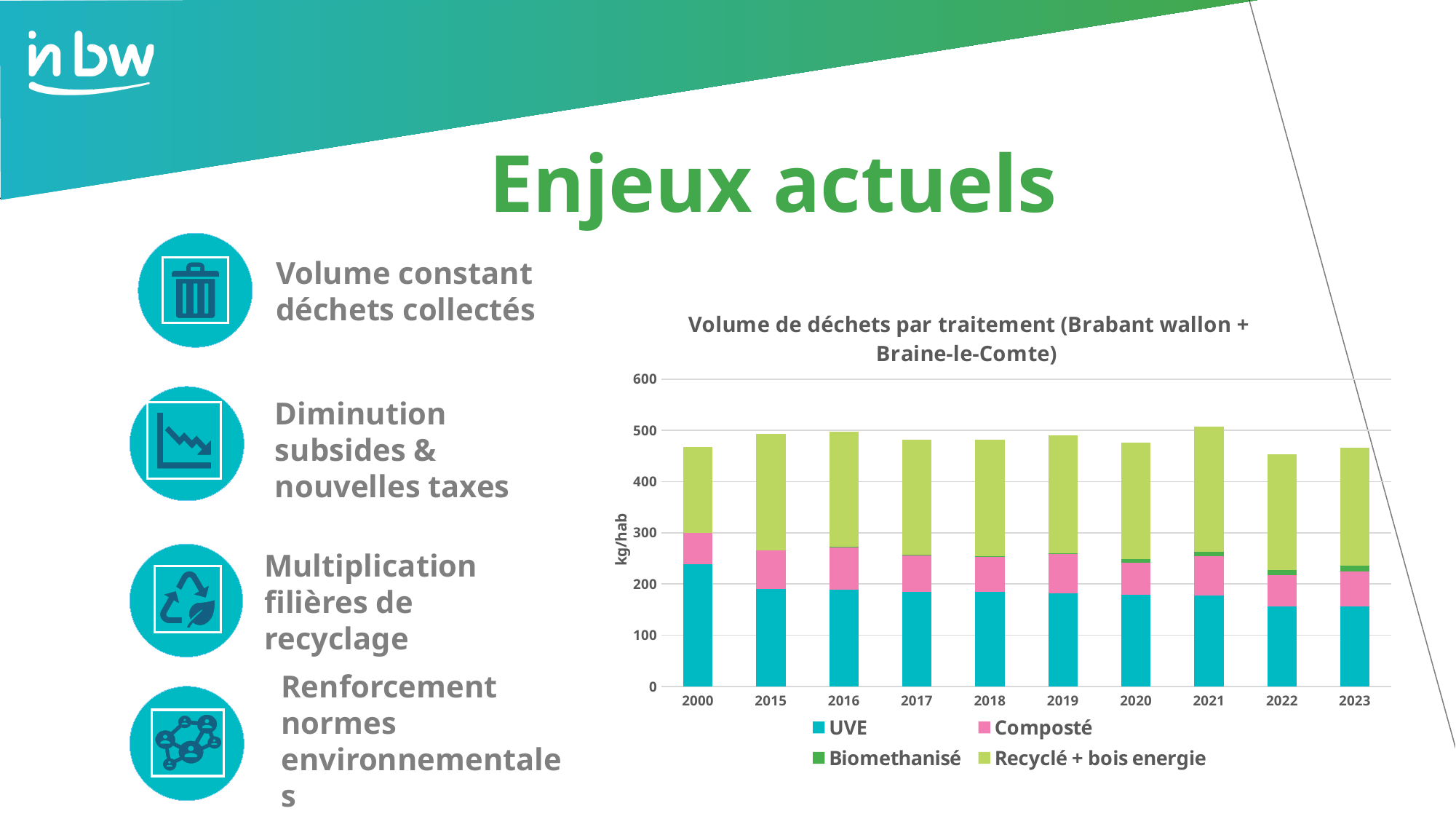
Is the UVE value for 2000 greater or less than 200? greater Is the total stacked value for 2021 greater or less than 500? greater Is the UVE value for 2023 greater or less than 200? less Which year has the highest total stacked bar? 2021 What unit is shown on the y axis of the chart? kg/hab Which is larger, the UVE value for 2000 or the UVE value for 2023? 2000 What kind of chart is shown on the slide? stacked bar chart What is the title of the chart? Volume de déchets par traitement (Brabant wallon + Braine-le-Comte) How many series does the chart legend list? 4 How many years are shown on the x axis of the chart? 10 Does the UVE series generally rise or fall from 2000 to 2023? fall